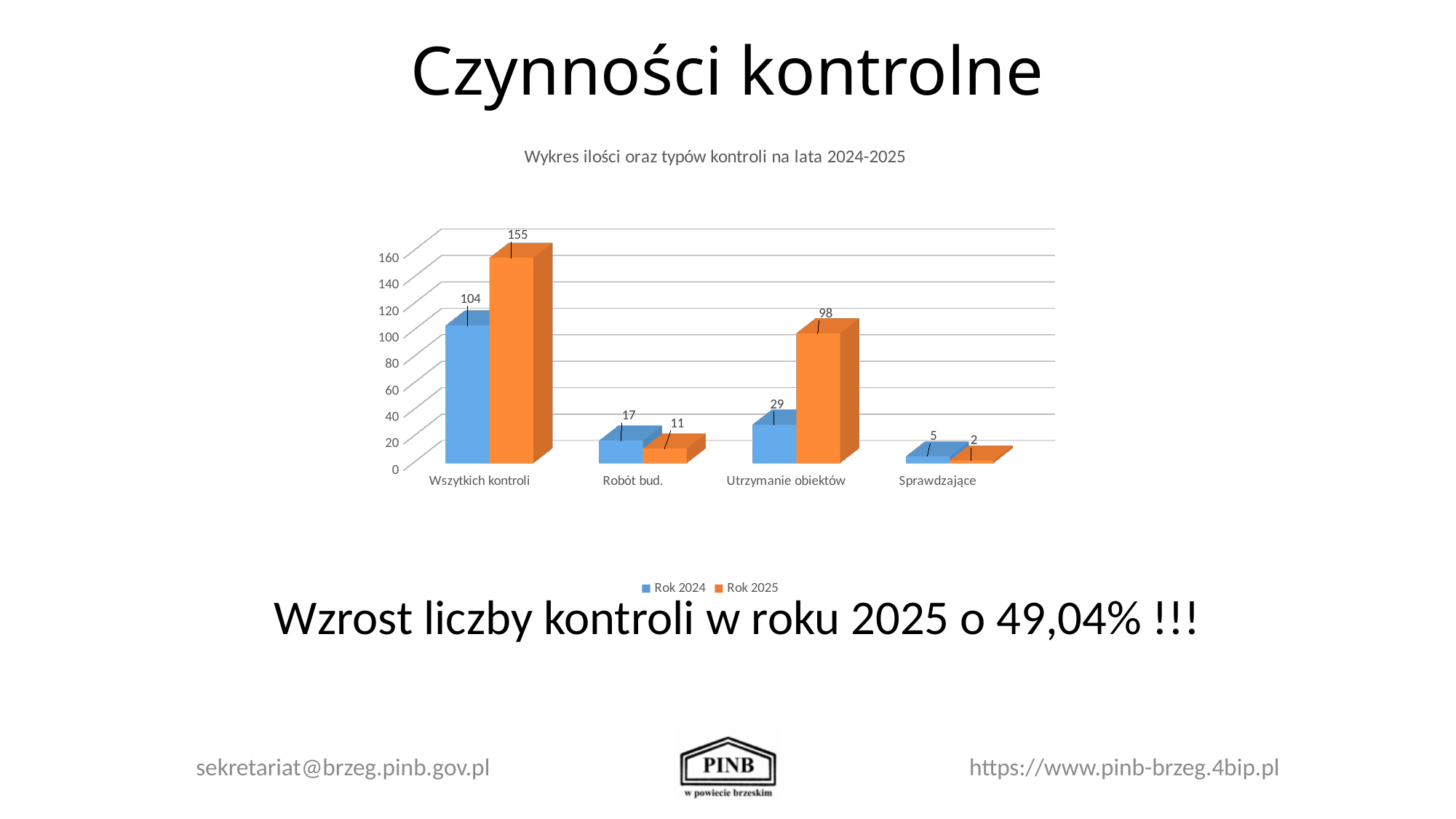
What is the difference between the Rok 2025 and Rok 2024 values for Wszytkich kontroli? 51 How many categories are shown on the x axis? 4 What is the value for Rok 2024 in the Sprawdzające category? 5 What is the value for Rok 2024 in the Utrzymanie obiektów category? 29 What kind of chart is shown on the slide? Bar chart What is the value for Rok 2025 in the Wszytkich kontroli category? 155 Which category has the lowest value for Rok 2024? Sprawdzające How many series does the legend list? 2 What is the value for Rok 2025 in the Robót bud. category? 11 Which is larger for Robót bud.: the Rok 2024 value or the Rok 2025 value? Rok 2024 Which category has the highest value for Rok 2025? Wszytkich kontroli What is the title of the chart? Wykres ilości oraz typów kontroli na lata 2024-2025